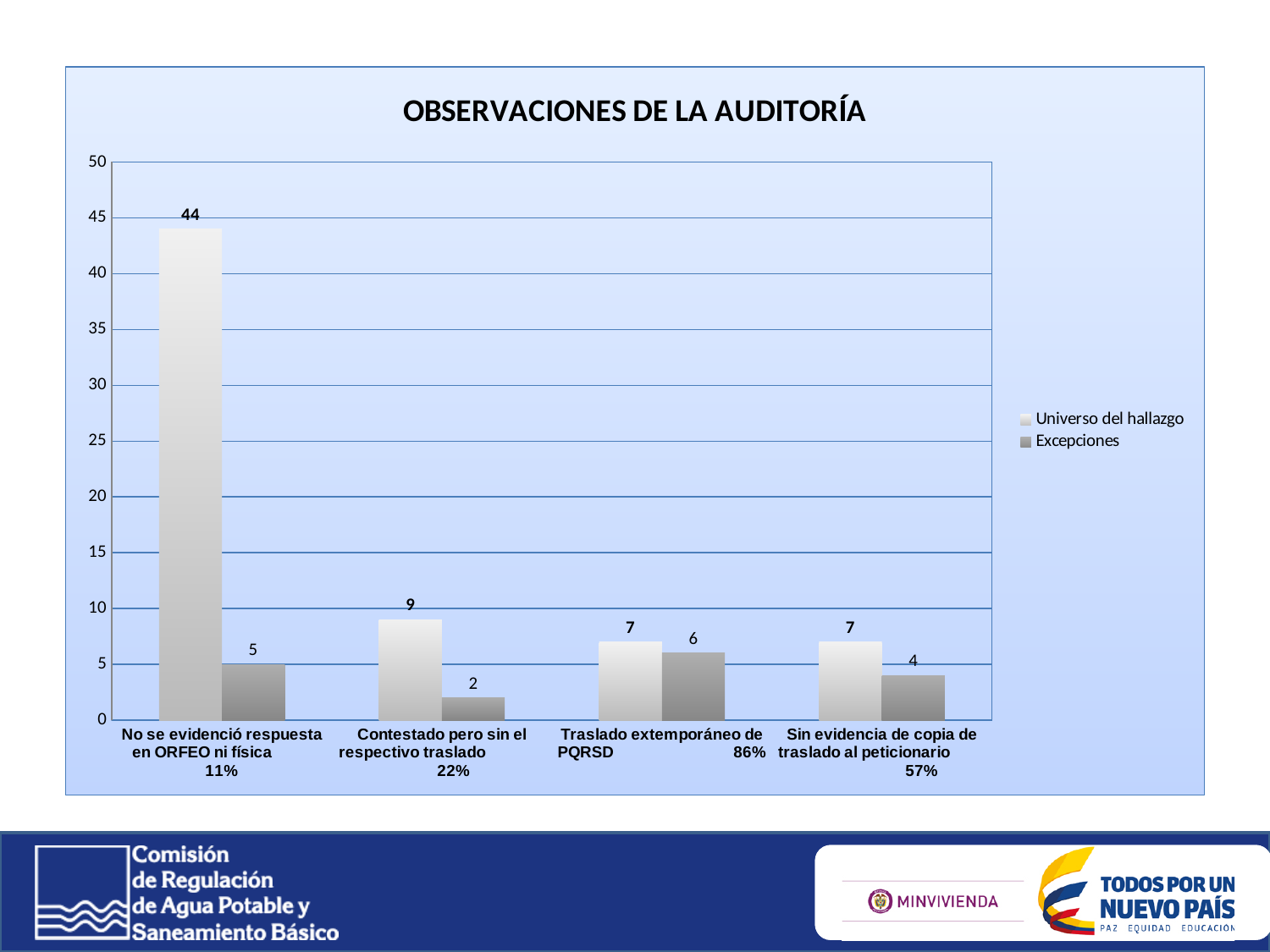
What kind of chart is shown on the slide? Bar chart Which is larger: 'Excepciones' for 'Traslado extemporáneo de PQRSD' or 'Excepciones' for 'Sin evidencia de copia de traslado al peticionario'? Traslado extemporáneo de PQRSD What is the value of 'Excepciones' for 'Traslado extemporáneo de PQRSD'? 6 What is the title of the chart? OBSERVACIONES DE LA AUDITORÍA How many categories are shown on the x axis? 4 What is the value of 'Excepciones' for 'Contestado pero sin el respectivo traslado'? 2 Which category has the highest 'Universo del hallazgo' value? No se evidenció respuesta en ORFEO ni física What is the value of 'Universo del hallazgo' for 'No se evidenció respuesta en ORFEO ni física'? 44 Which category has the lowest 'Excepciones' value? Contestado pero sin el respectivo traslado What is the difference between 'Universo del hallazgo' and 'Excepciones' for 'No se evidenció respuesta en ORFEO ni física'? 39 How many series does the legend list? 2 Is the 'Universo del hallazgo' value for 'No se evidenció respuesta en ORFEO ni física' greater or less than 40? greater